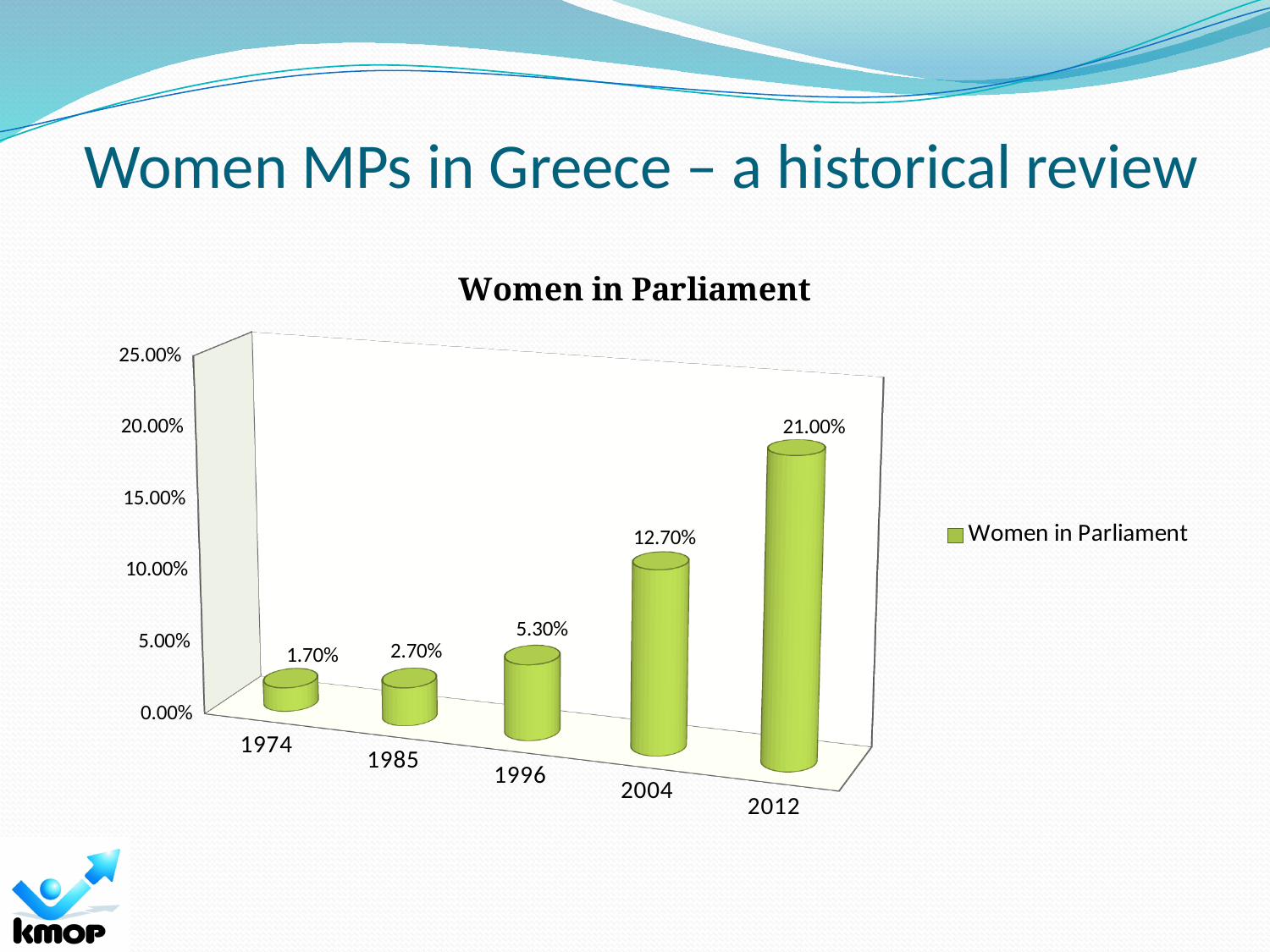
Which year has the highest value in the Women in Parliament chart? 2012 What is the value for 2004 in the Women in Parliament chart? 12.70% Do the values in the Women in Parliament chart rise or fall from 1974 to 2012? rise What is the value for 1974 in the Women in Parliament chart? 1.70% Is the value for 2012 in the Women in Parliament chart greater or less than 20.00%? greater Which is larger in the Women in Parliament chart, the value for 1996 or the value for 1985? 1996 What is the value for 1996 in the Women in Parliament chart? 5.30% What is the difference between the values for 2012 and 2004 in the Women in Parliament chart? 8.30% What kind of chart is the Women in Parliament chart? bar chart How many years are shown on the x axis of the Women in Parliament chart? 5 Which year has the lowest value in the Women in Parliament chart? 1974 What is the difference between the values for 1985 and 1974 in the Women in Parliament chart? 1.00%